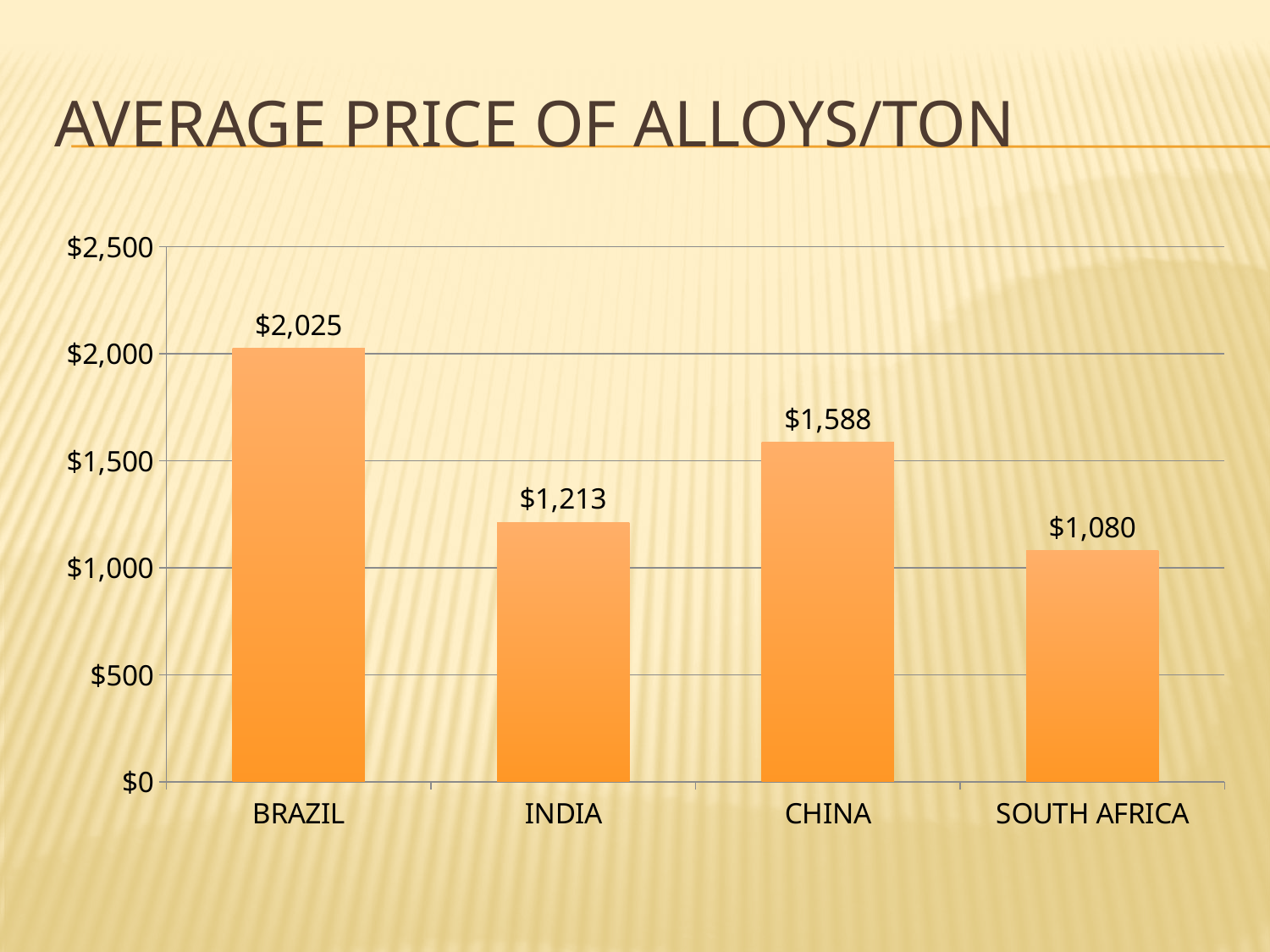
Which has a higher average price of alloys per ton, India or China? China Which country has the highest average price of alloys per ton? Brazil What kind of chart is shown on the slide? Bar chart What is the average price of alloys per ton for Brazil? $2,025 Is the value for South Africa greater or less than $1,000? greater What is the average price of alloys per ton for South Africa? $1,080 What is the average price of alloys per ton for India? $1,213 How many countries are shown in the chart? 4 What is the average price of alloys per ton for China? $1,588 What is the difference between the average price for Brazil and the average price for China? $437 What is the difference between the average price for India and the average price for South Africa? $133 Which country has the lowest average price of alloys per ton? South Africa